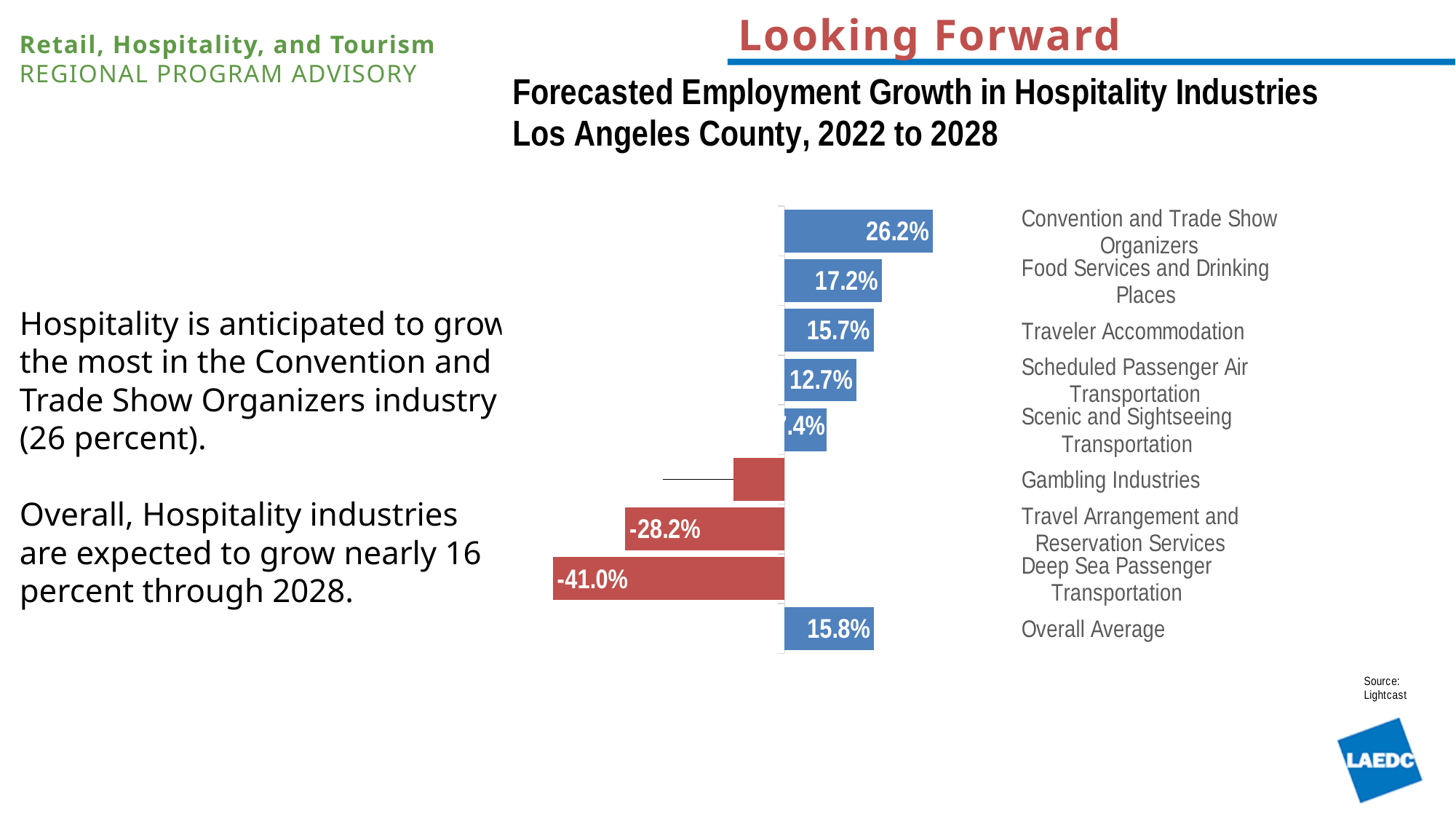
What is the forecasted employment growth for Traveler Accommodation? 15.7% What type of chart is shown on the slide? Bar chart What is the forecasted employment growth for Convention and Trade Show Organizers? 26.2% What is the difference in forecasted growth between Convention and Trade Show Organizers and Food Services and Drinking Places? 9.0 percentage points Which industry has the lowest forecasted employment growth? Deep Sea Passenger Transportation What is the forecasted employment growth for Scheduled Passenger Air Transportation? 12.7% How many categories (bars) are shown in the chart? 9 What is the forecasted employment growth for Food Services and Drinking Places? 17.2% What is the Overall Average forecasted employment growth shown in the chart? 15.8% What is the forecasted employment growth for Travel Arrangement and Reservation Services? -28.2% What is the forecasted employment growth for Deep Sea Passenger Transportation? -41.0% Which industry has the highest forecasted employment growth? Convention and Trade Show Organizers